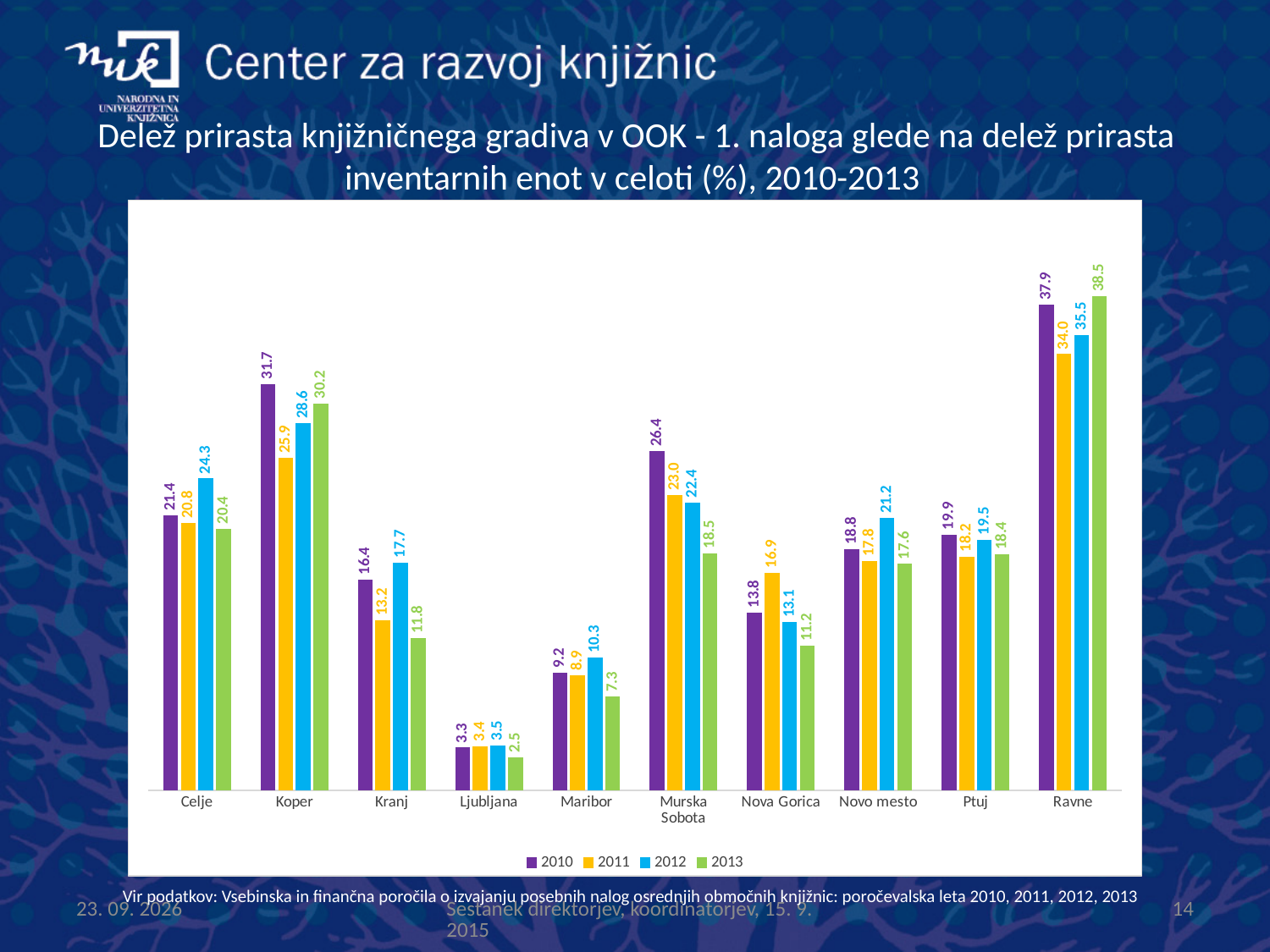
Which colour represents the 2011 series in the legend? yellow What kind of chart is shown on the slide? bar chart What is the value for Murska Sobota in 2013? 18.5 Do the values for Kranj rise or fall from 2012 to 2013? fall Which is larger for Celje: the 2012 value or the 2013 value? 2012 What is the difference between the 2010 and 2013 values for Murska Sobota? 7.9 Which library has the lowest value in 2010? Ljubljana What is the value for Nova Gorica in 2011? 16.9 How many series does the legend list? 4 What is the value for Koper in 2010? 31.7 Which library has the highest value in 2013? Ravne How many libraries (categories) are shown on the x axis? 10